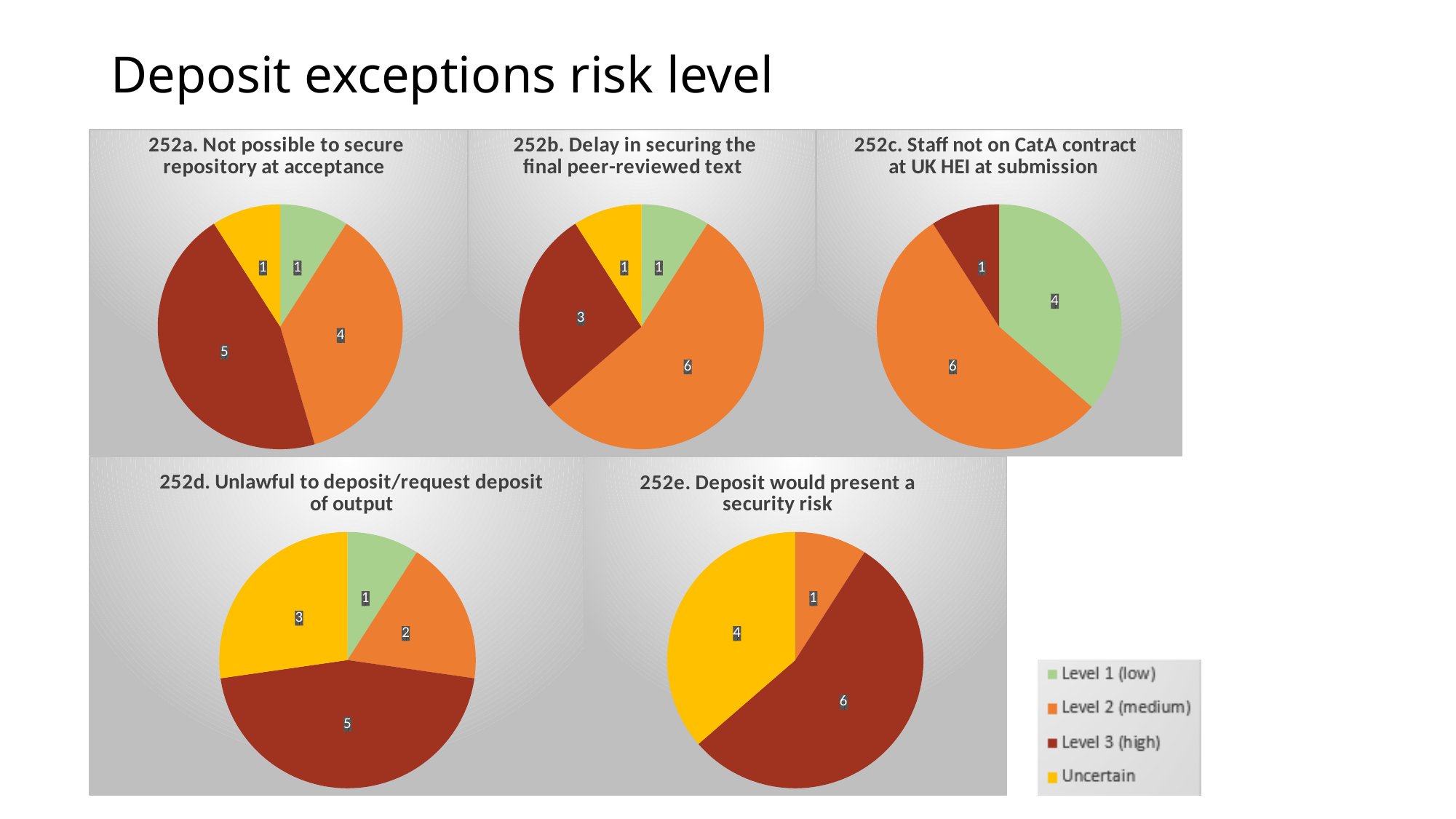
In the '252a. Not possible to secure repository at acceptance' chart, what is the difference between the Level 3 (high) and Level 2 (medium) values? 1 In the '252c. Staff not on CatA contract at UK HEI at submission' chart, which category has the smallest slice? Level 3 (high) In the '252e. Deposit would present a security risk' chart, which category has the largest slice? Level 3 (high) In the '252c. Staff not on CatA contract at UK HEI at submission' chart, what is the value for Level 1 (low)? 4 In the '252d. Unlawful to deposit/request deposit of output' chart, what share of the total does Level 3 (high) represent? 5 of 11 In the '252b. Delay in securing the final peer-reviewed text' chart, what is the value for Level 2 (medium)? 6 How many slices does the '252e. Deposit would present a security risk' pie chart have? 3 In the '252a. Not possible to secure repository at acceptance' chart, what is the value for Level 3 (high)? 5 In the '252d. Unlawful to deposit/request deposit of output' chart, what is the value for Uncertain? 3 In the '252b. Delay in securing the final peer-reviewed text' chart, which is larger: Level 2 (medium) or Level 3 (high)? Level 2 (medium) What type of chart is used for '252d. Unlawful to deposit/request deposit of output'? Pie chart How many entries does the legend list? 4